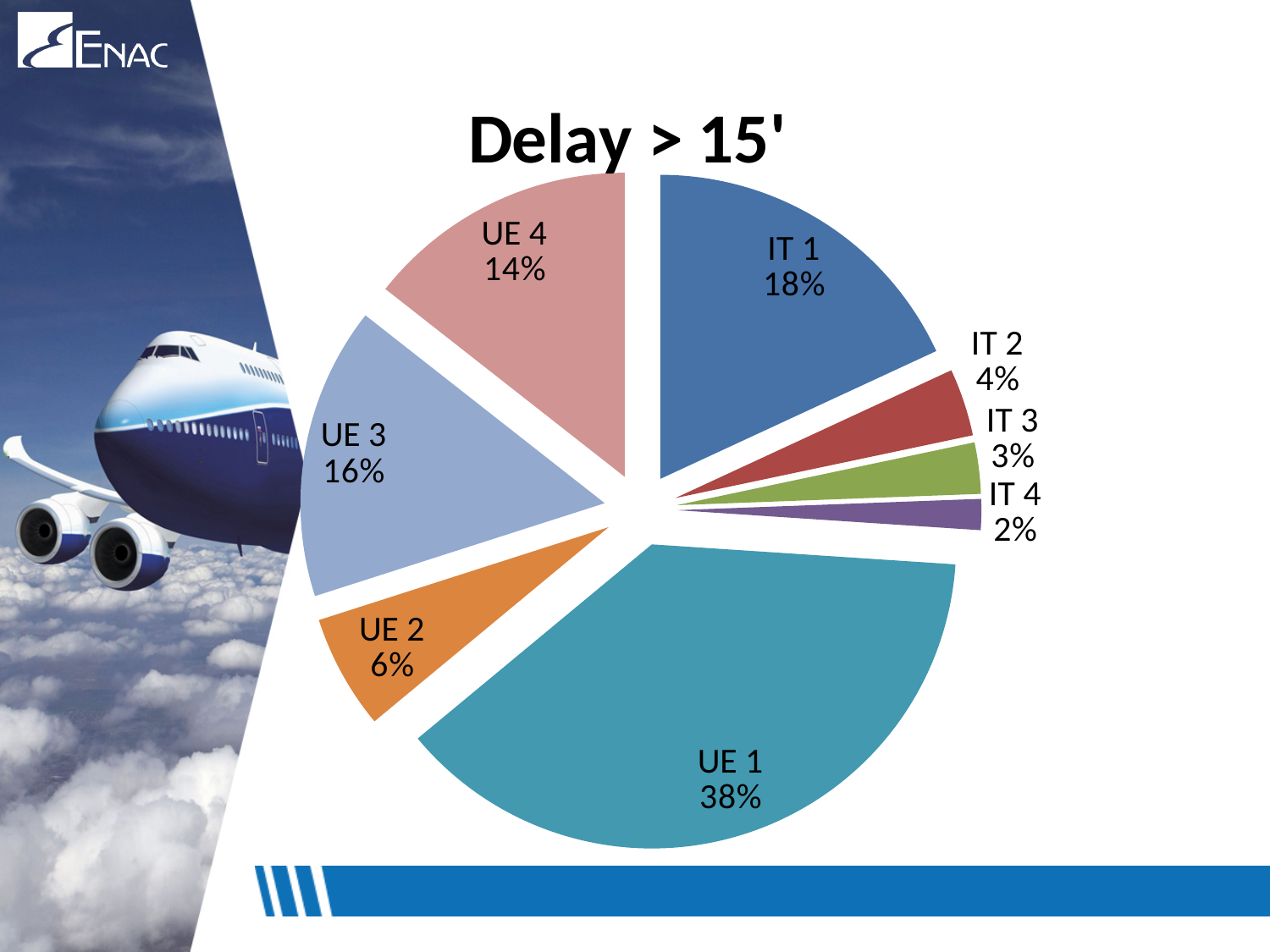
What is the value for IT 1? 18% Which category has the largest slice of the pie? UE 1 What is the title of the chart? Delay > 15' How many slices does the pie chart have? 8 What is the combined share of IT 2, IT 3 and IT 4? 9% Which is larger, the value for UE 4 or the value for UE 2? UE 4 What is the difference between the values for UE 1 and IT 1? 20% What share of the pie does UE 1 have? 38% What is the value for UE 3? 16% Which category has the smallest slice of the pie? IT 4 What is the value for IT 4? 2% What kind of chart is shown on the slide? pie chart